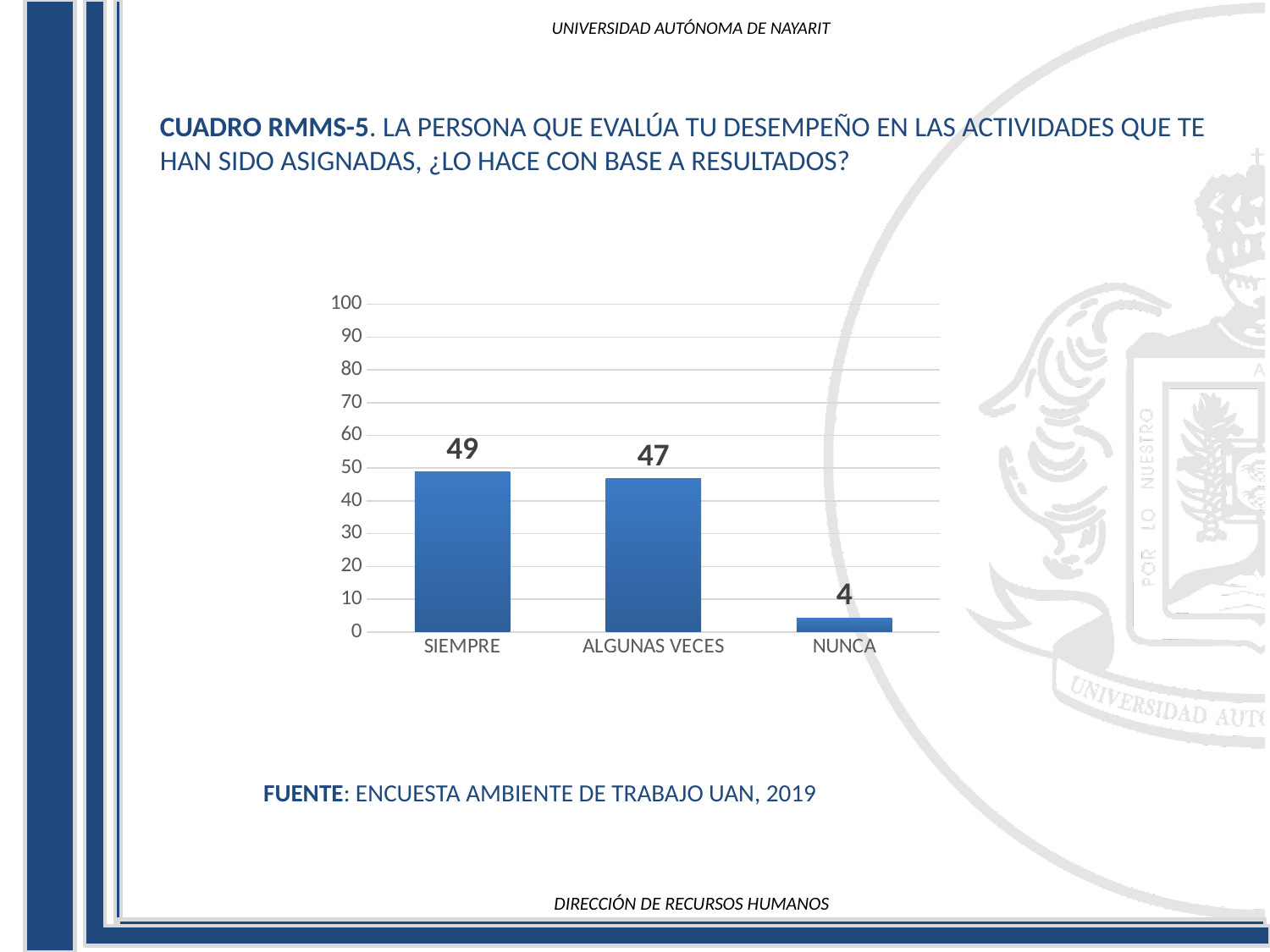
How many categories are shown on the x axis? 3 Which category has the lowest value? NUNCA Is the value for NUNCA greater or less than 10? less What is the source cited below the chart? ENCUESTA AMBIENTE DE TRABAJO UAN, 2019 What is the difference between the values for SIEMPRE and ALGUNAS VECES? 2 Which category has the highest value? SIEMPRE What is the value for ALGUNAS VECES? 47 What kind of chart is shown on the slide? bar chart Which is larger, the value for ALGUNAS VECES or the value for NUNCA? ALGUNAS VECES What is the difference between the values for SIEMPRE and NUNCA? 45 What is the value for SIEMPRE? 49 What is the value for NUNCA? 4